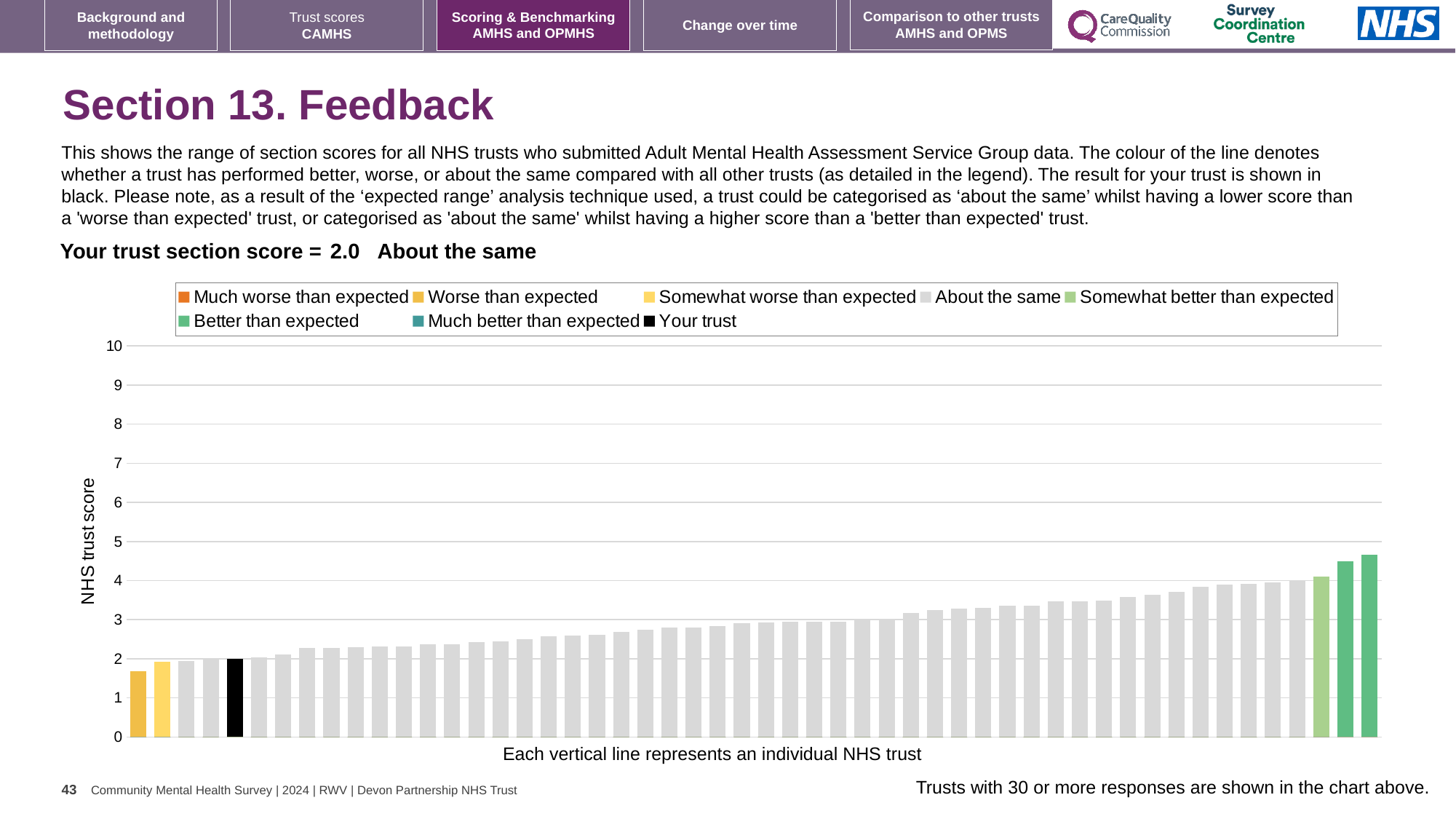
How many entries does the chart legend list? 8 Which legend category does the tallest bar in the chart belong to? Better than expected What is the section score for your trust shown on the slide? 2.0 What kind of chart is shown on the slide? bar chart What is the highest value shown on the vertical axis of the chart? 10 Which legend category does the shortest bar in the chart belong to? Worse than expected Is the value of the leftmost bar in the chart greater or less than 2? less Do the bar values rise or fall from left to right across the chart? rise Is the value of the tallest bar in the chart greater or less than 4? greater What is the label on the vertical axis of the chart? NHS trust score Which category is your trust's section score placed in? About the same Is the value of the black 'Your trust' bar greater or less than 3? less